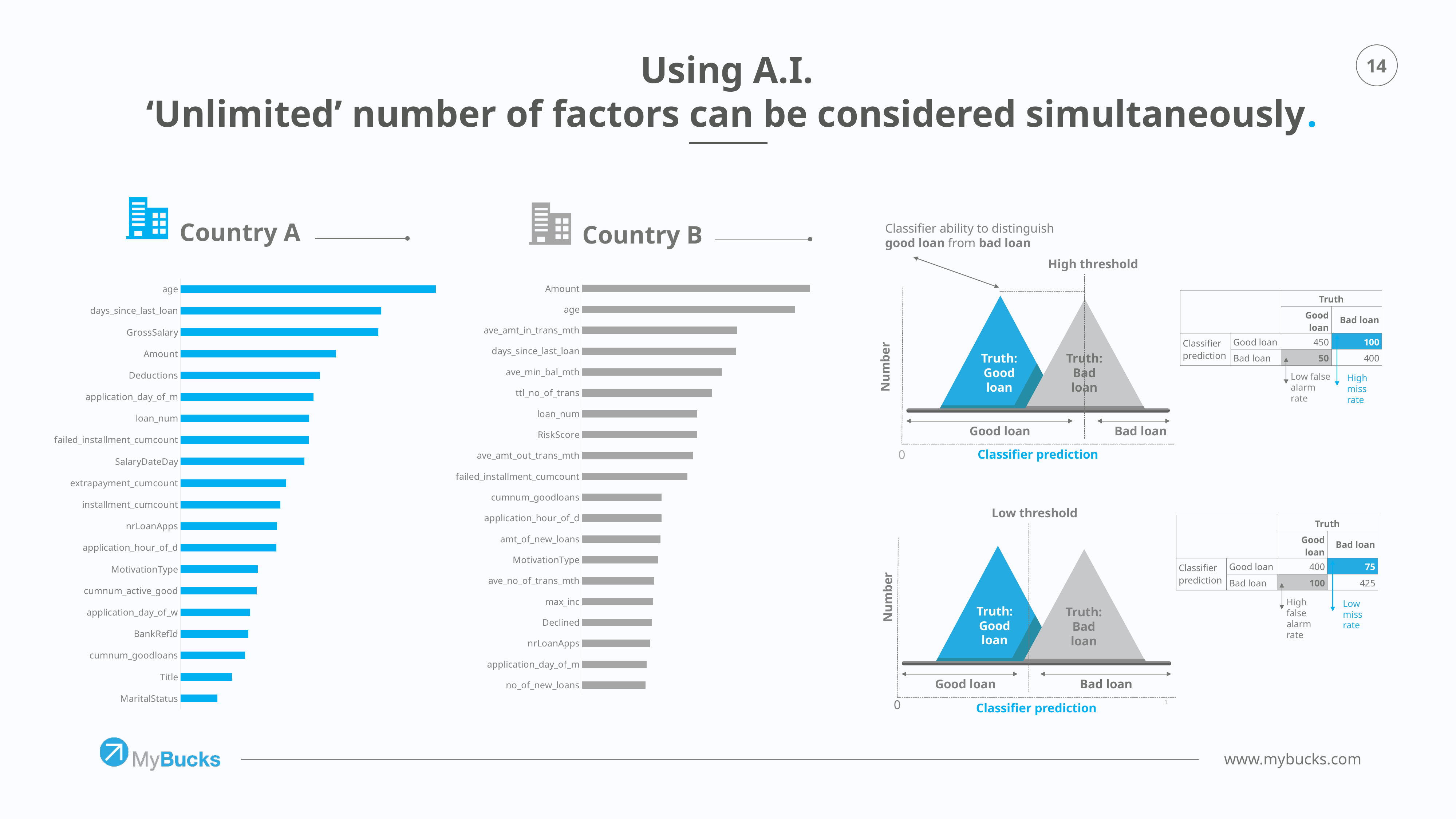
What kind of chart is the Country A chart? bar chart In the Country B chart, which factor has the longest bar? Amount In the Country B chart, which has the larger value, age or RiskScore? age In the High threshold table, how many loans are predicted as good loan when the truth is good loan? 450 How many factors are listed in the Country B chart? 20 In the Country A chart, which factor has the shortest bar? MaritalStatus What colour are the bars in the Country A chart? blue How many factors are listed in the Country A chart? 20 What colour are the bars in the Country B chart? grey In the Country A chart, which has the larger value, GrossSalary or Deductions? GrossSalary In the Country B chart, do the bars get longer or shorter going from top to bottom? shorter In the Country A chart, which factor has the longest bar? age